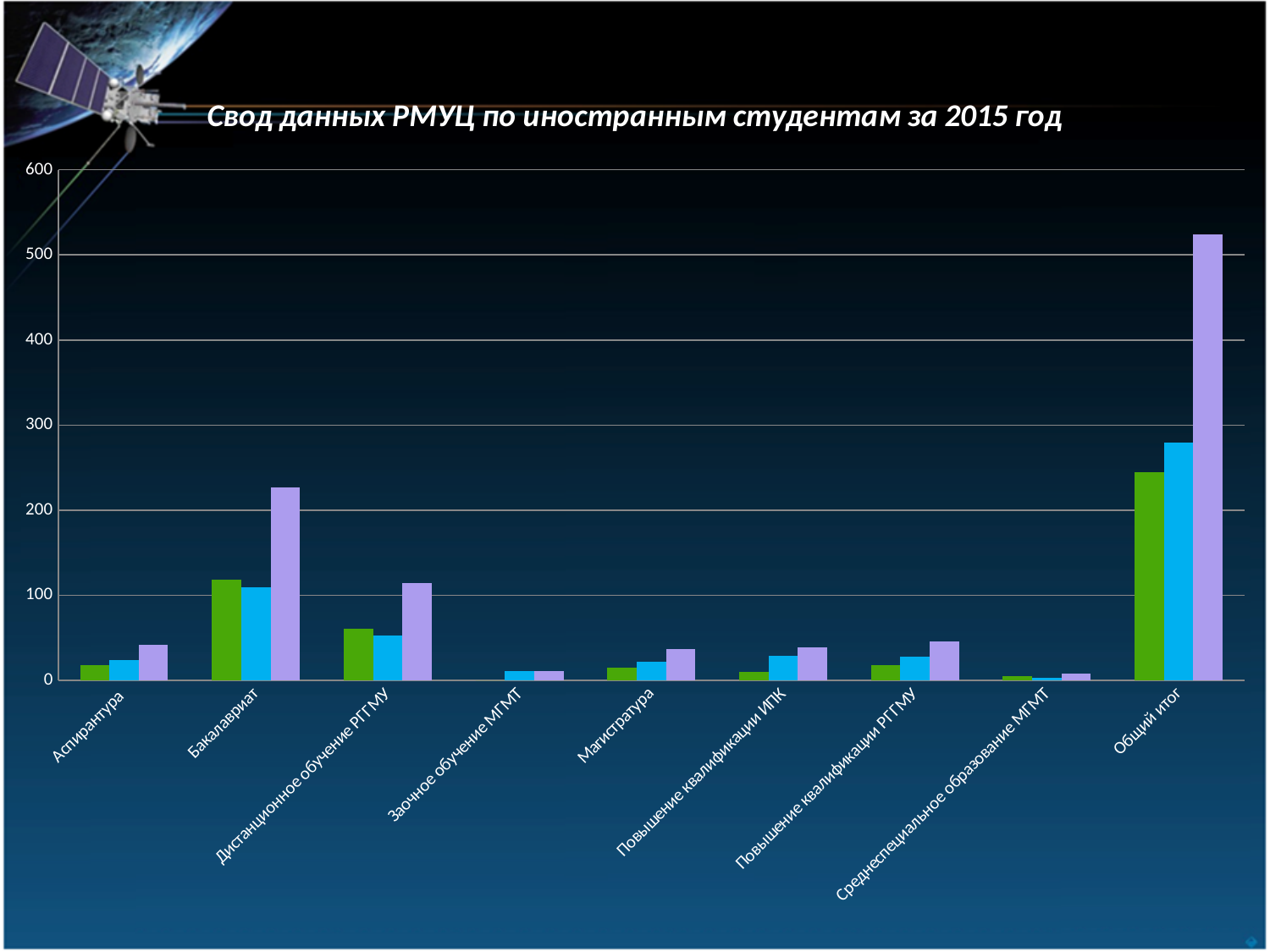
What is the title of the chart? Свод данных РМУЦ по иностранным студентам за 2015 год How many bars are plotted for each category in the chart? 3 How many categories are shown on the x axis of the chart? 9 What type of chart is shown on the slide? bar chart Is the purple bar for Бакалавриат greater or less than 200? greater Which has the larger purple bar, Бакалавриат or Дистанционное обучение РГГМУ? Бакалавриат Which category has the tallest bar in the chart? Общий итог Is the purple bar for Аспирантура greater or less than 100? less Is the blue bar for Дистанционное обучение РГГМУ greater or less than 100? less Which has the larger green bar, Бакалавриат or Магистратура? Бакалавриат